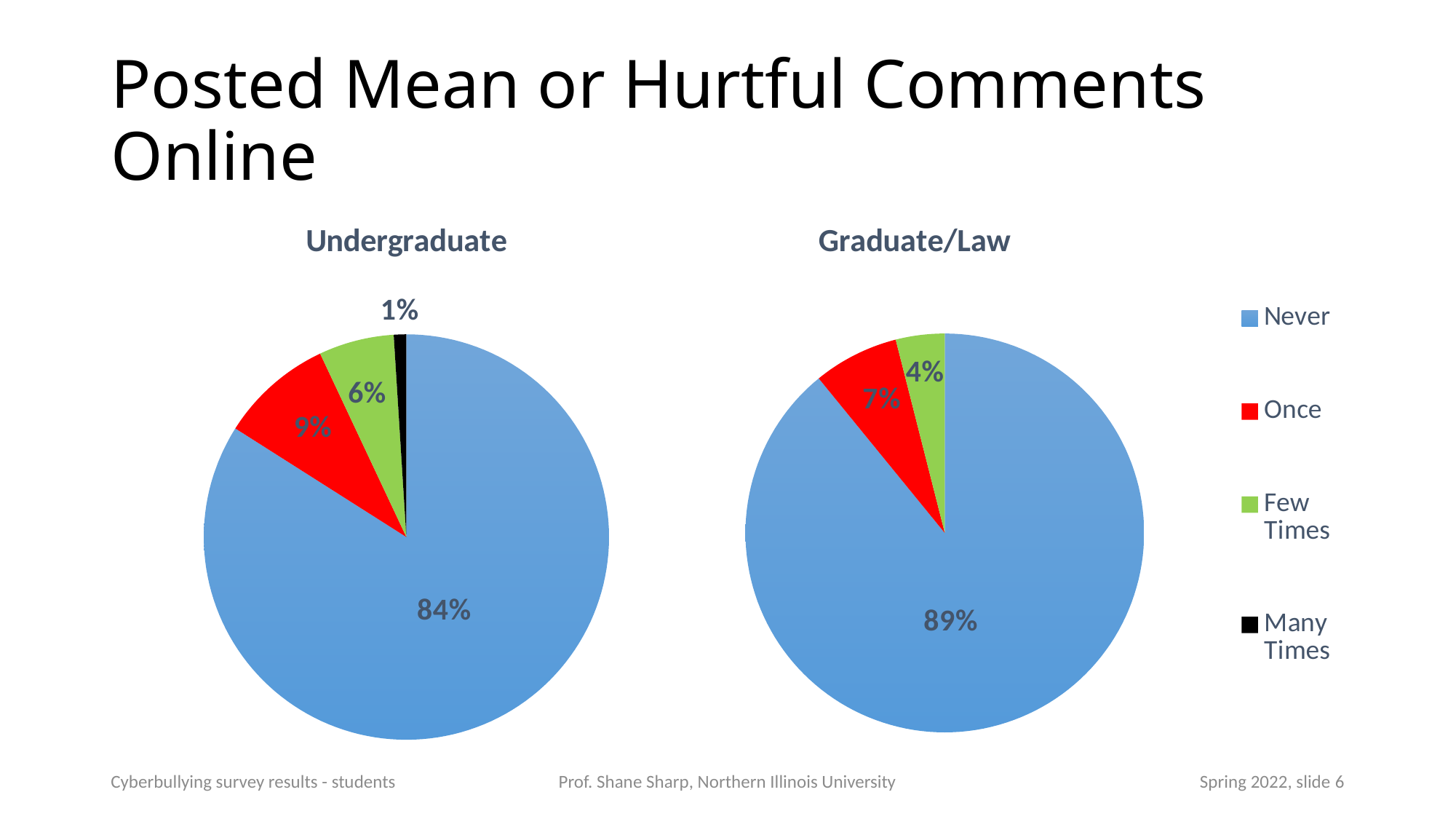
In the Graduate/Law pie chart, what percentage of respondents answered Never? 89% In the Undergraduate pie chart, which category has the largest share? Never What colour represents the Once category in the pie charts? Red What is the difference between the Never share in the Graduate/Law chart and the Never share in the Undergraduate chart? 5% In the Undergraduate pie chart, which category has the smallest share? Many Times How many categories does the legend list? 4 In the Undergraduate pie chart, what percentage answered Many Times? 1% In the Graduate/Law pie chart, what percentage answered Few Times? 4% In the Undergraduate pie chart, what percentage of respondents answered Never? 84% What type of chart is used on this slide? Pie chart In the Undergraduate pie chart, what percentage answered Once? 9% Which is larger: the Once share in the Undergraduate chart or the Once share in the Graduate/Law chart? Undergraduate